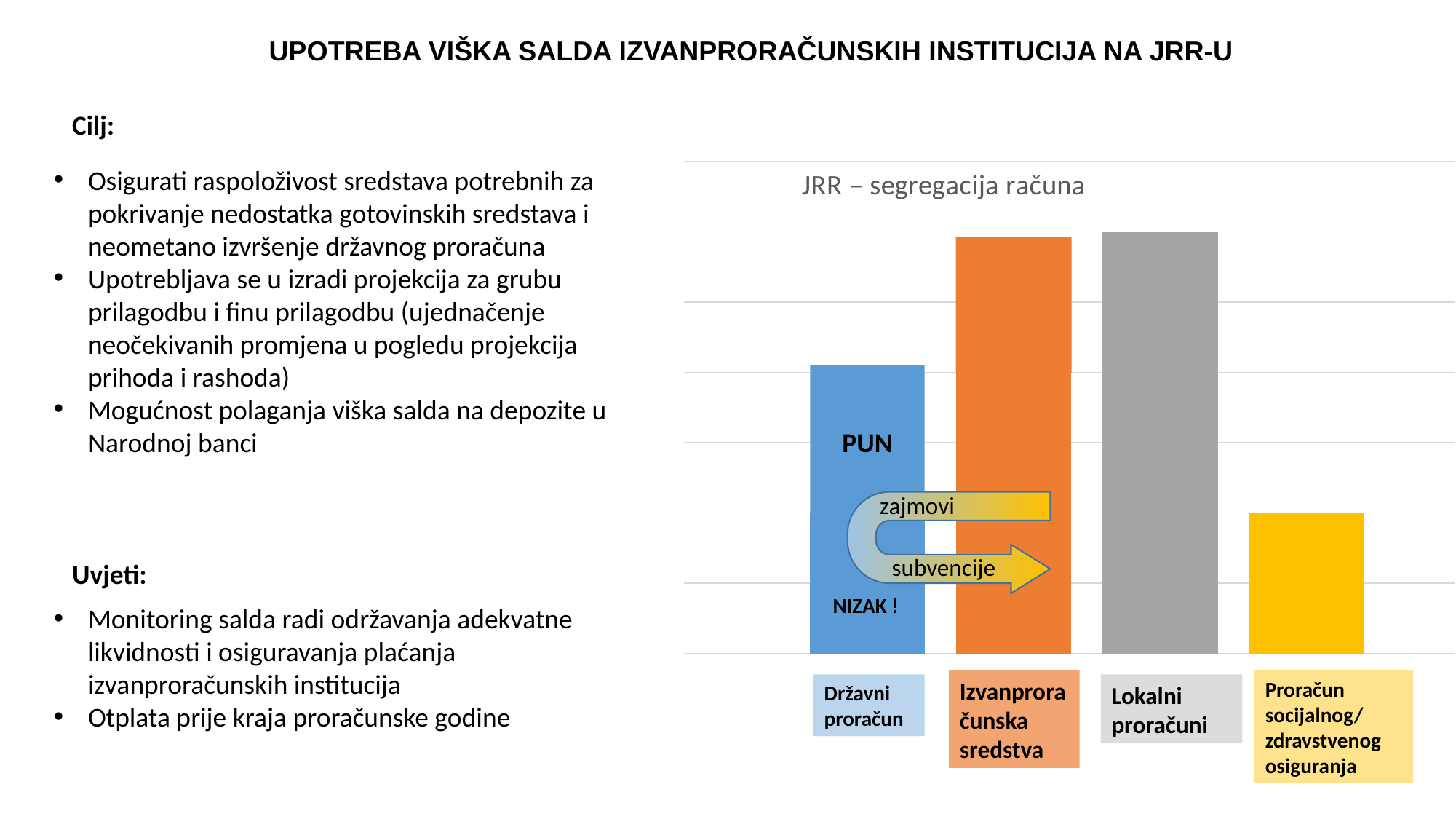
What kind of chart is shown on the slide? bar chart Which bar is taller: Lokalni proračuni or Državni proračun? Lokalni proračuni Which category has the lowest bar in the chart? Proračun socijalnog/zdravstvenog osiguranja What colour is the bar for Državni proračun? blue Which bar is taller: Izvanproračunska sredstva or Državni proračun? Izvanproračunska sredstva What is the title of the chart? JRR – segregacija računa How many categories (bars) does the chart show? 4 Which bar is taller: Lokalni proračuni or Proračun socijalnog/zdravstvenog osiguranja? Lokalni proračuni